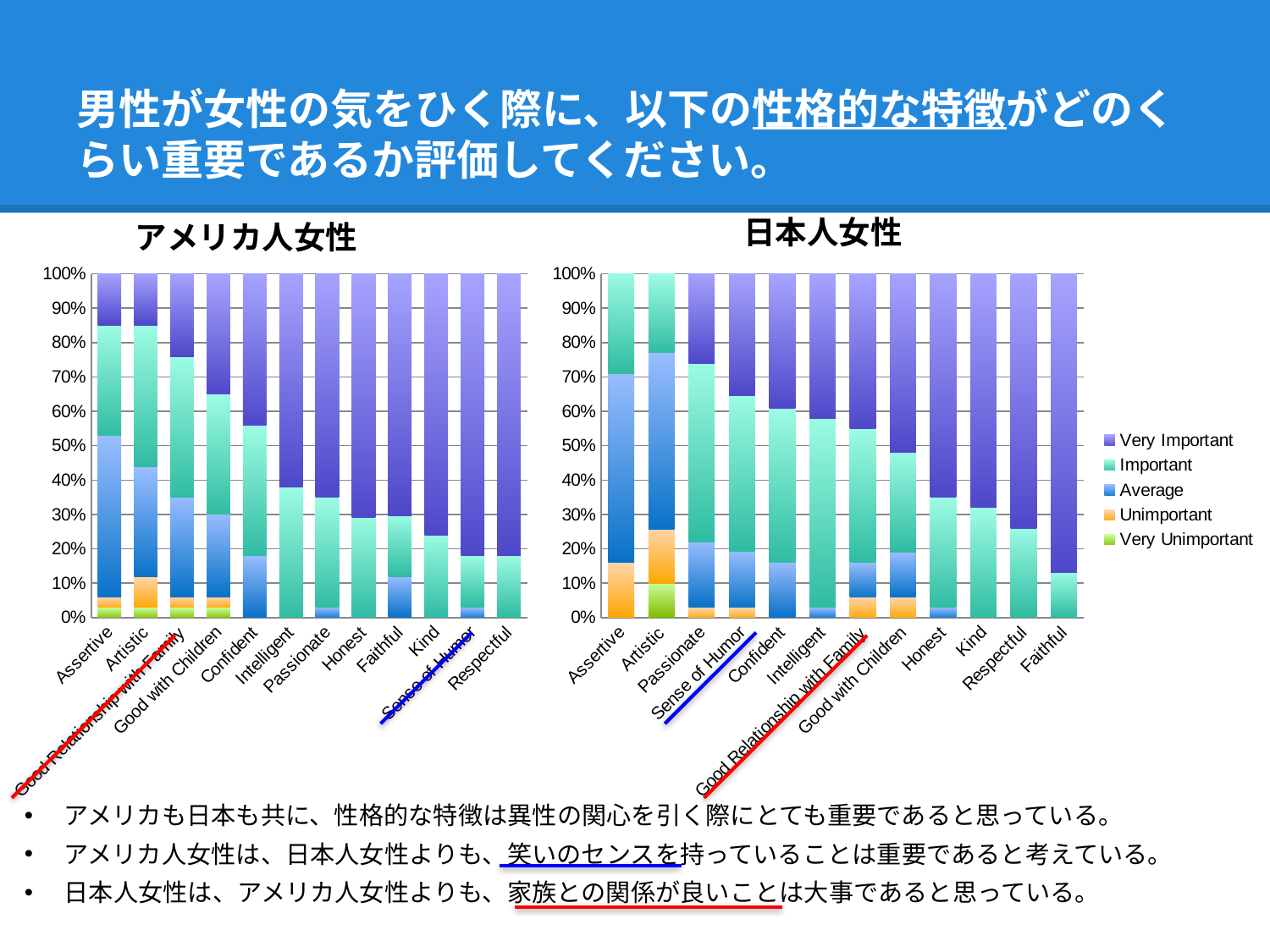
In the アメリカ人女性 chart, is the Very Important segment for Faithful greater or less than 60% of the bar? greater In the 日本人女性 chart, is the Very Important segment for Faithful greater or less than 80% of the bar? greater In the 日本人女性 chart, which category has the largest Very Unimportant segment? Artistic How many categories are shown on the x axis of the 日本人女性 chart on the right? 12 In the アメリカ人女性 chart, which category has the largest Average segment? Assertive In the アメリカ人女性 chart, what is the total of the stacked bar for Honest? 100% How many series does the legend list for the charts? 5 In the アメリカ人女性 chart, which category has the larger Very Important segment, Respectful or Assertive? Respectful What kind of chart is the アメリカ人女性 chart on the left? Stacked bar chart What are the five series named in the legend? Very Important, Important, Average, Unimportant, Very Unimportant Which chart is on the left of the slide, アメリカ人女性 or 日本人女性? アメリカ人女性 In the アメリカ人女性 chart, is the Very Important segment for Confident greater or less than 50% of the bar? less